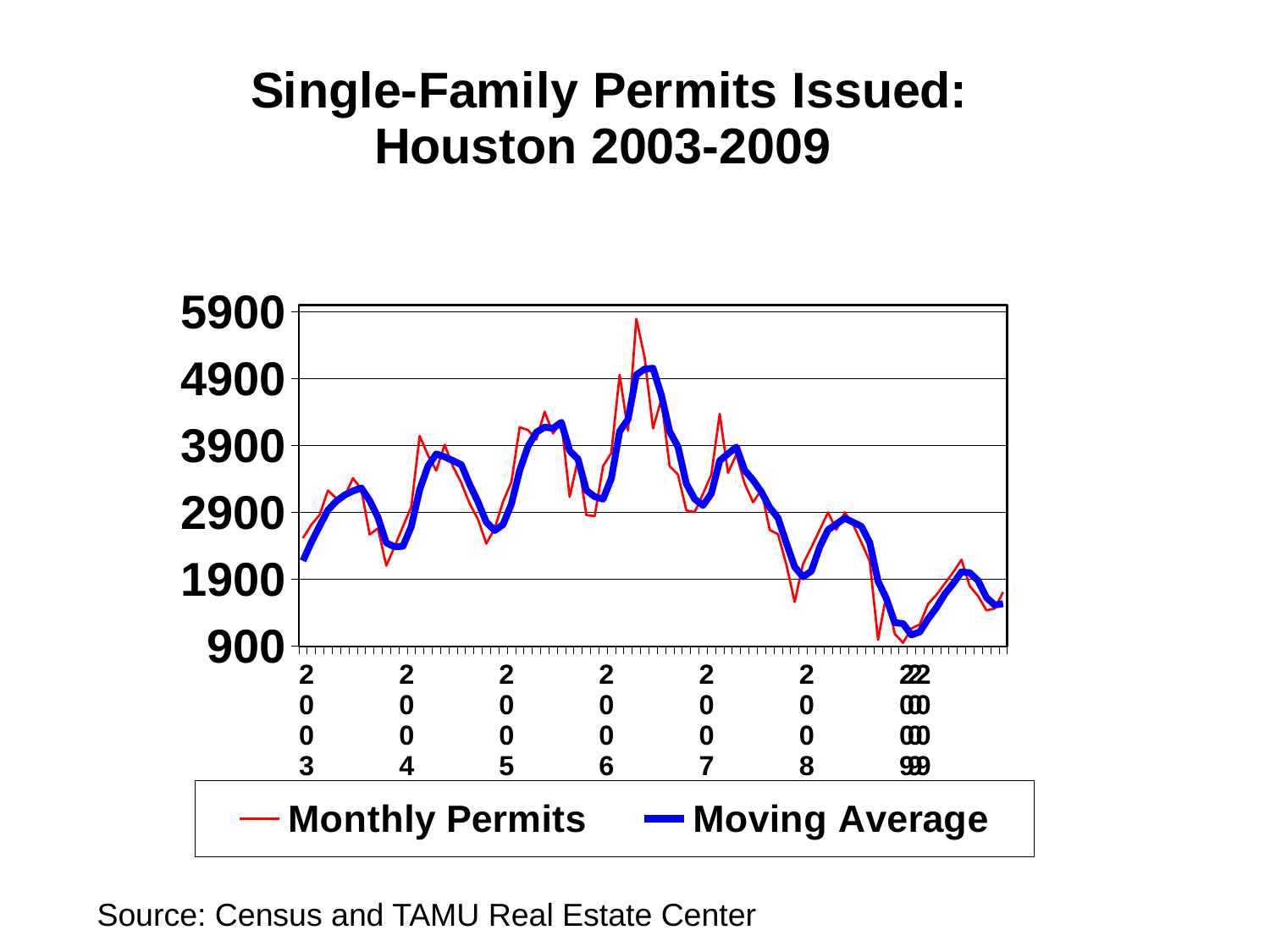
What is the title of the chart? Single-Family Permits Issued: Houston 2003-2009 Is the highest value of the Monthly Permits series greater or less than 4900? greater Is the peak of the Moving Average series greater or less than 3900? greater Is the lowest value of the Monthly Permits series, reached in 2009, greater or less than 1900? less In which year does the Monthly Permits series reach its highest peak? 2006 What kind of chart is shown on the slide? Line chart Do the Moving Average values rise or fall from 2007 to 2009? Fall How many series does the legend list? 2 Do the Moving Average values rise or fall from the start of 2003 to the peak in 2006? Rise Which series is drawn with the thick blue line? Moving Average